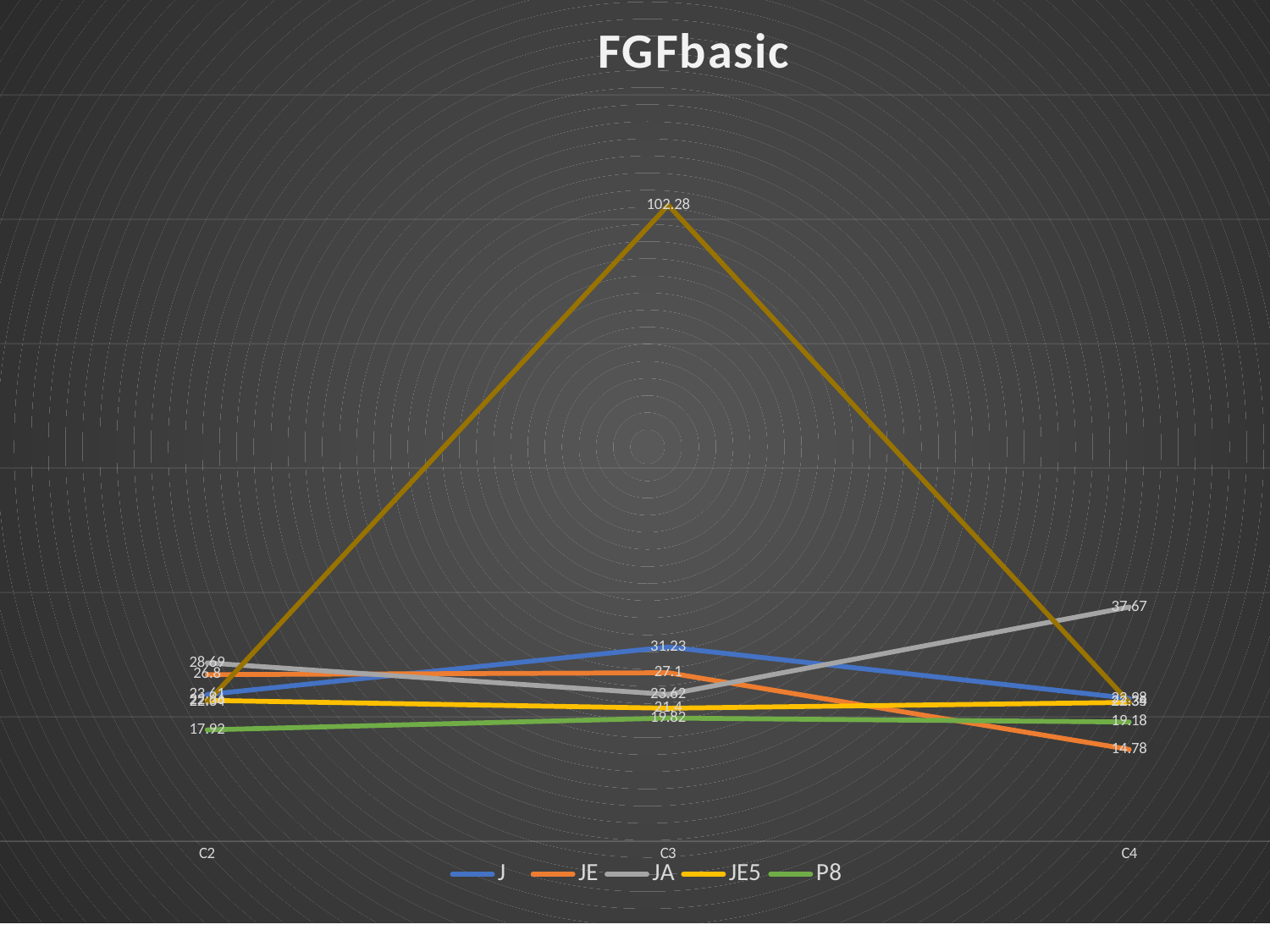
How many categories are shown on the x axis? 3 What is the value of JA at C4? 37.67 How many series does the legend list? 5 What is the title of the chart? FGFbasic What is the value of J at C3? 31.23 What is the difference between JA and JE at C4? 22.89 Which is larger at C3, J or JE? J What kind of chart is shown on the slide? line chart What is the value of P8 at C2? 17.92 What is the highest value labelled on the chart? 102.28 What is the value of JE at C4? 14.78 Which series has the lowest value at C4? JE